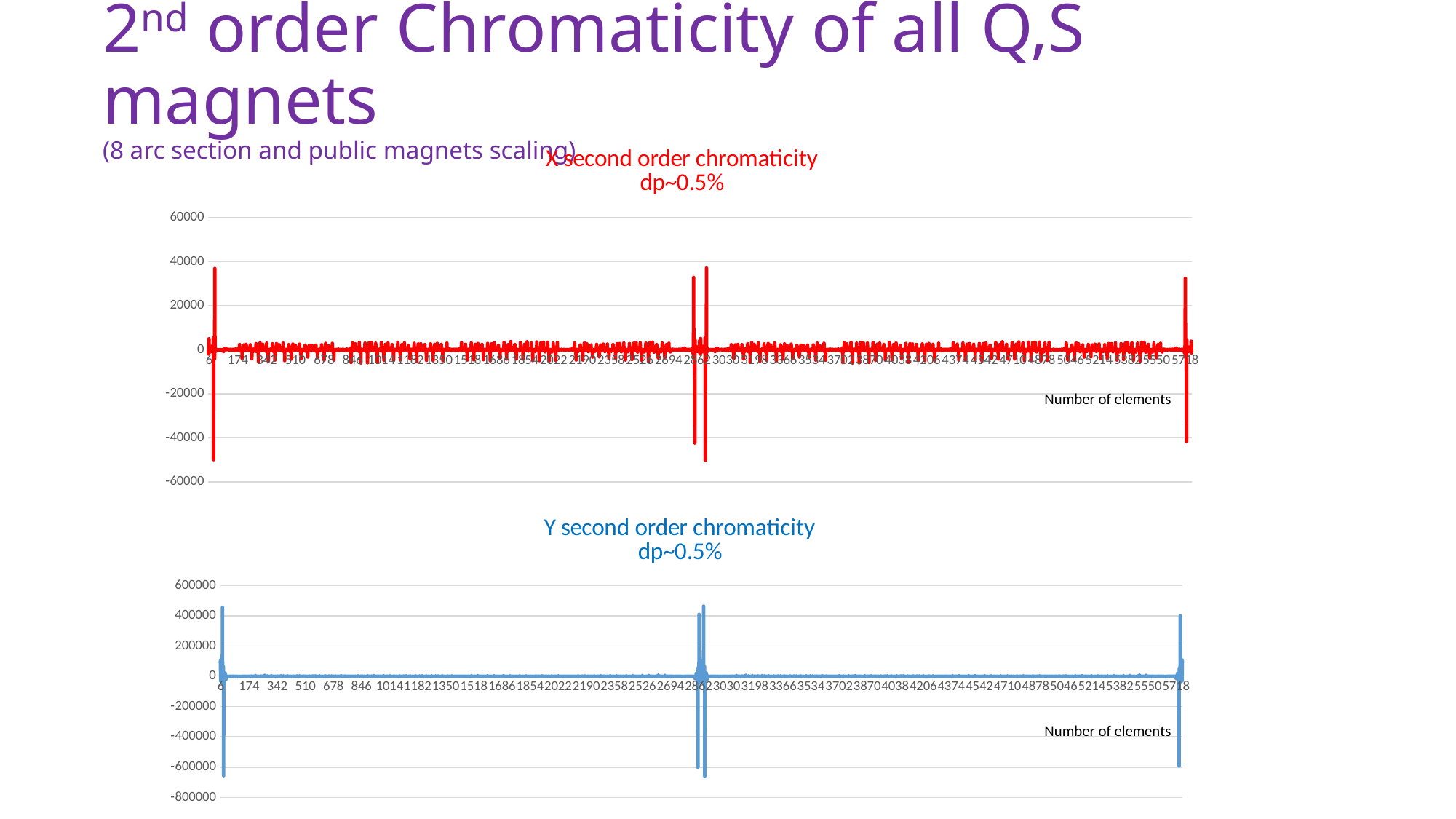
In the 'X second order chromaticity' chart, what colour is the plotted line? red In the 'Y second order chromaticity' chart, what label is written on the x axis? Number of elements In the 'Y second order chromaticity' chart, is the value at the x-axis label 4038 greater or less than 200000? less In the 'Y second order chromaticity' chart, is the highest spike near the start of the x axis greater or less than 200000? greater In the 'X second order chromaticity' chart, is the lowest spike near the start of the x axis greater or less than -40000? less What kind of chart is the 'Y second order chromaticity dp~0.5%' chart? line chart What kind of chart is the 'X second order chromaticity dp~0.5%' chart? line chart